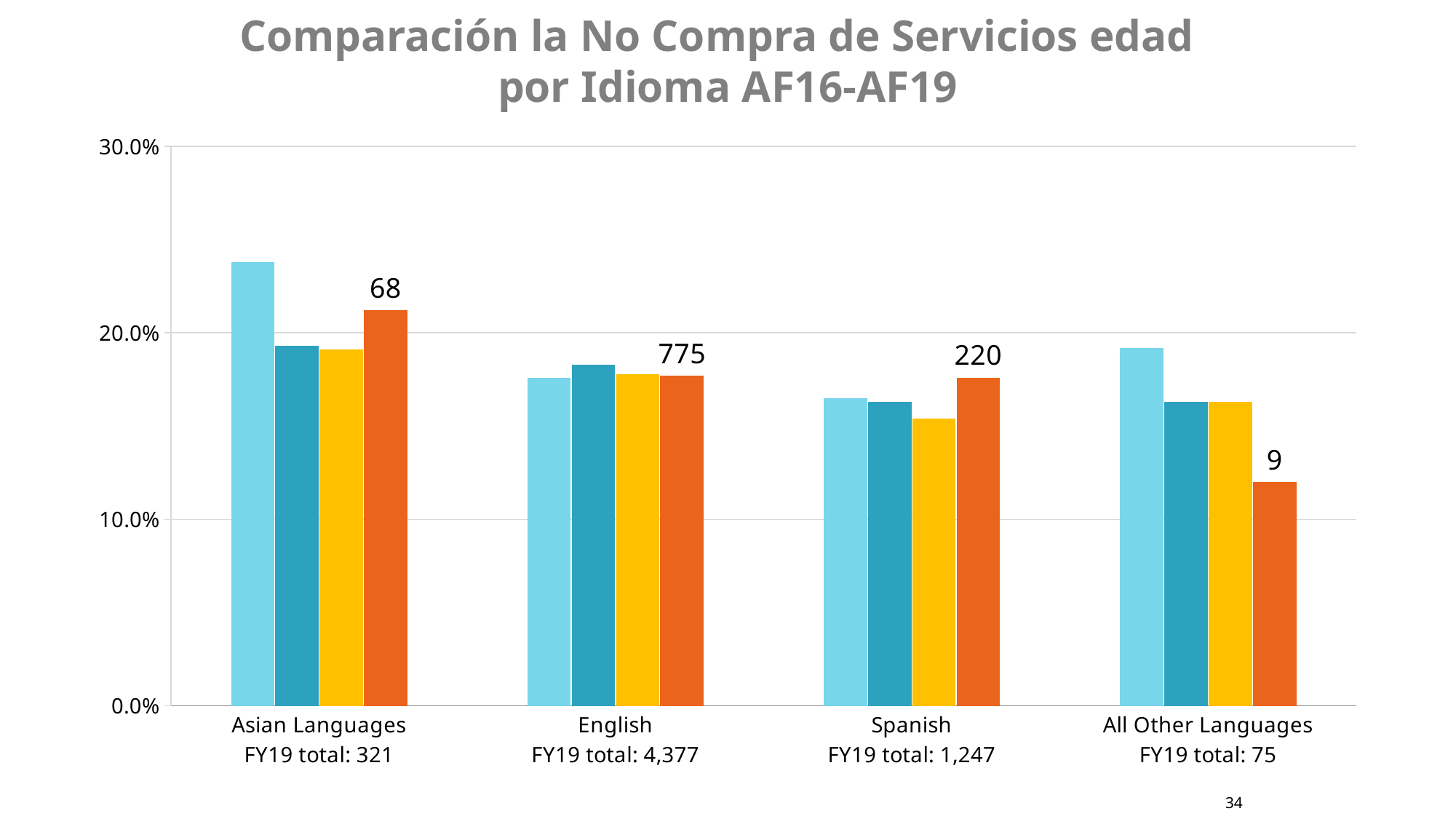
What kind of chart is shown on the slide? bar chart How many language categories are shown on the x axis? 4 What data label is printed above the orange bar for Asian Languages? 68 Which category has the smallest data label on its orange bar? All Other Languages Is the value of the orange bar for All Other Languages greater or less than 20.0%? less Which category has the largest data label on its orange bar? English What data label is printed above the orange bar for All Other Languages? 9 Is the value of the orange bar for Asian Languages greater or less than 20.0%? greater What data label is printed above the orange bar for English? 775 What FY19 total is shown for Spanish on the x axis label? 1,247 What data label is printed above the orange bar for Spanish? 220 How many bars are plotted for each language category? 4